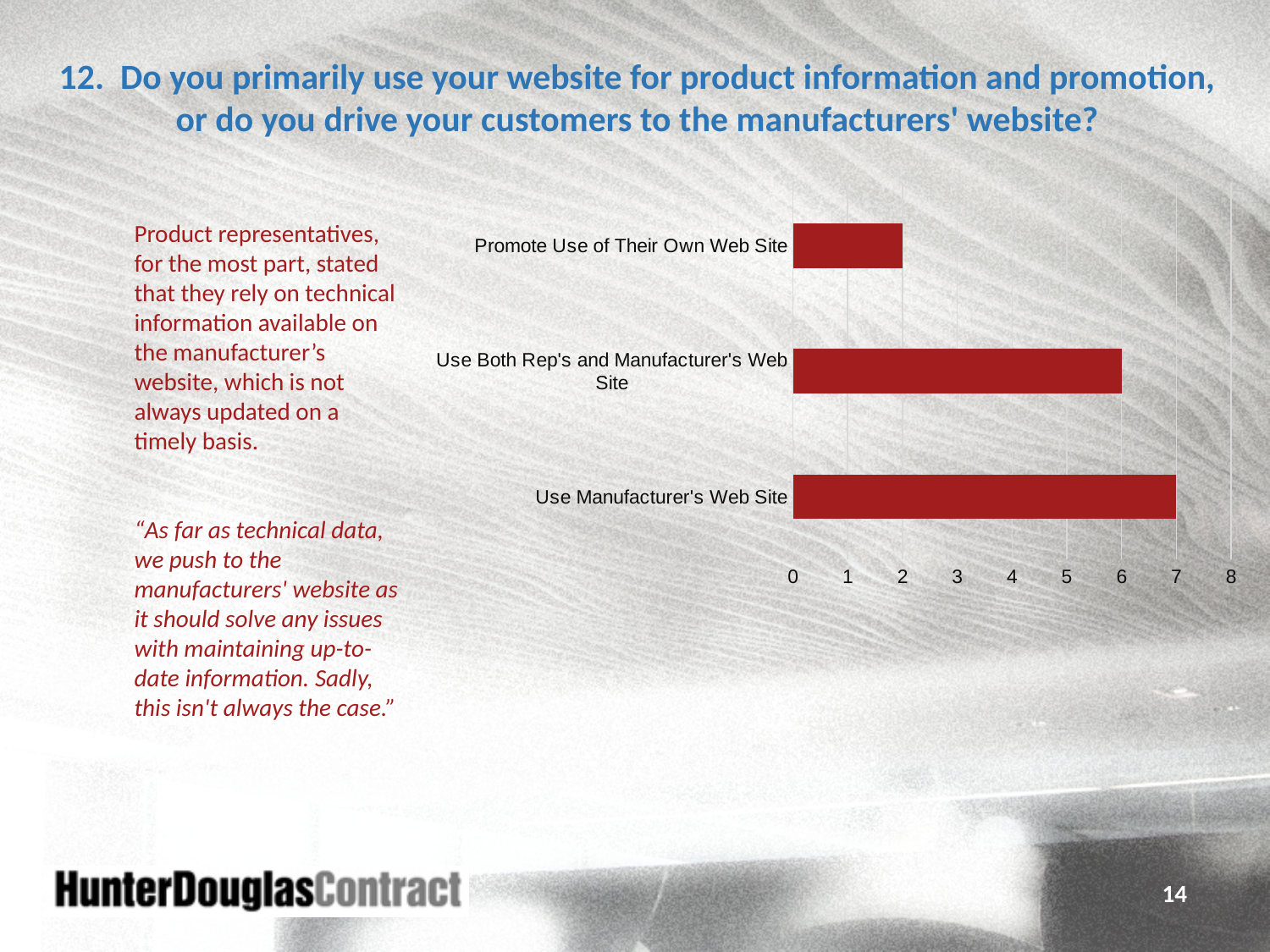
What is the value for Use Both Rep's and Manufacturer's Web Site? 6 Which category has the lowest value? Promote Use of Their Own Web Site Is the value for Use Both Rep's and Manufacturer's Web Site greater or less than 4? greater How many categories does the chart show? 3 What is the difference between the value for Use Manufacturer's Web Site and the value for Promote Use of Their Own Web Site? 5 Which category has the highest value? Use Manufacturer's Web Site What is the value for Use Manufacturer's Web Site? 7 Which is larger: the value for Use Manufacturer's Web Site or the value for Promote Use of Their Own Web Site? Use Manufacturer's Web Site Is the value for Promote Use of Their Own Web Site greater or less than 4? less What kind of chart is shown on the slide? bar chart What is the value for Promote Use of Their Own Web Site? 2 What is the highest value shown on the chart's horizontal axis? 8